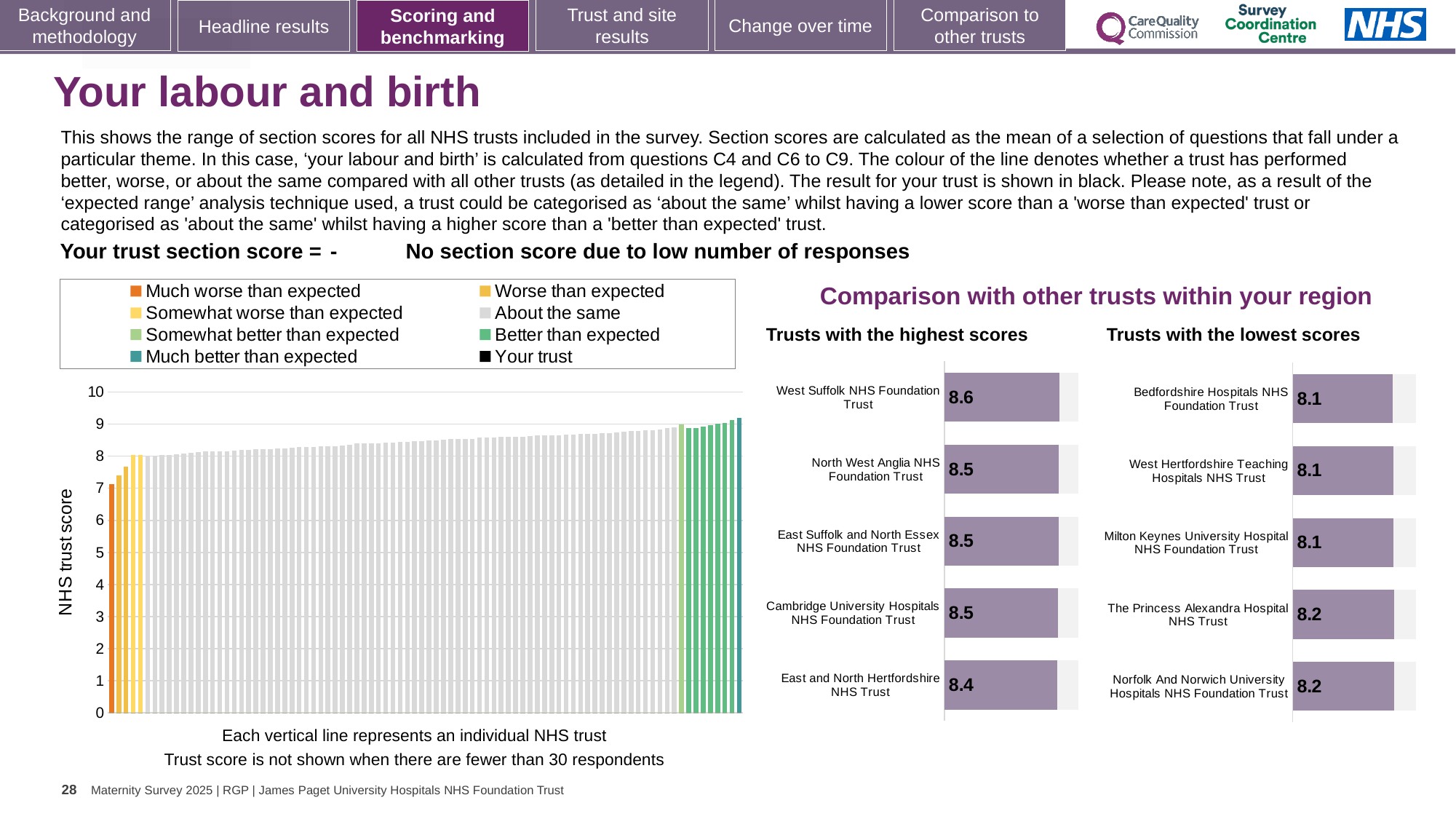
In the 'Trusts with the highest scores' chart, which trust has the lowest score? East and North Hertfordshire NHS Trust In the 'Trusts with the lowest scores' chart, what is the score for The Princess Alexandra Hospital NHS Trust? 8.2 What kind of chart is the large chart on the left showing NHS trust scores? Bar chart In the large chart on the left showing NHS trust scores, do the values rise or fall from left to right? Rise Which is larger: the score for Norfolk And Norwich University Hospitals NHS Foundation Trust in the 'Trusts with the lowest scores' chart, or the score for Milton Keynes University Hospital NHS Foundation Trust in the same chart? Norfolk And Norwich University Hospitals NHS Foundation Trust In the 'Trusts with the highest scores' chart, what is the score for West Suffolk NHS Foundation Trust? 8.6 In the 'Trusts with the lowest scores' chart, what is the score for Bedfordshire Hospitals NHS Foundation Trust? 8.1 In the 'Trusts with the highest scores' chart, what is the difference between the scores of West Suffolk NHS Foundation Trust and East and North Hertfordshire NHS Trust? 0.2 How many trusts are shown in the 'Trusts with the lowest scores' chart? 5 In the 'Trusts with the highest scores' chart, what is the score for East and North Hertfordshire NHS Trust? 8.4 In the 'Trusts with the highest scores' chart, which trust has the highest score? West Suffolk NHS Foundation Trust How many entries does the legend above the large chart on the left list? 8